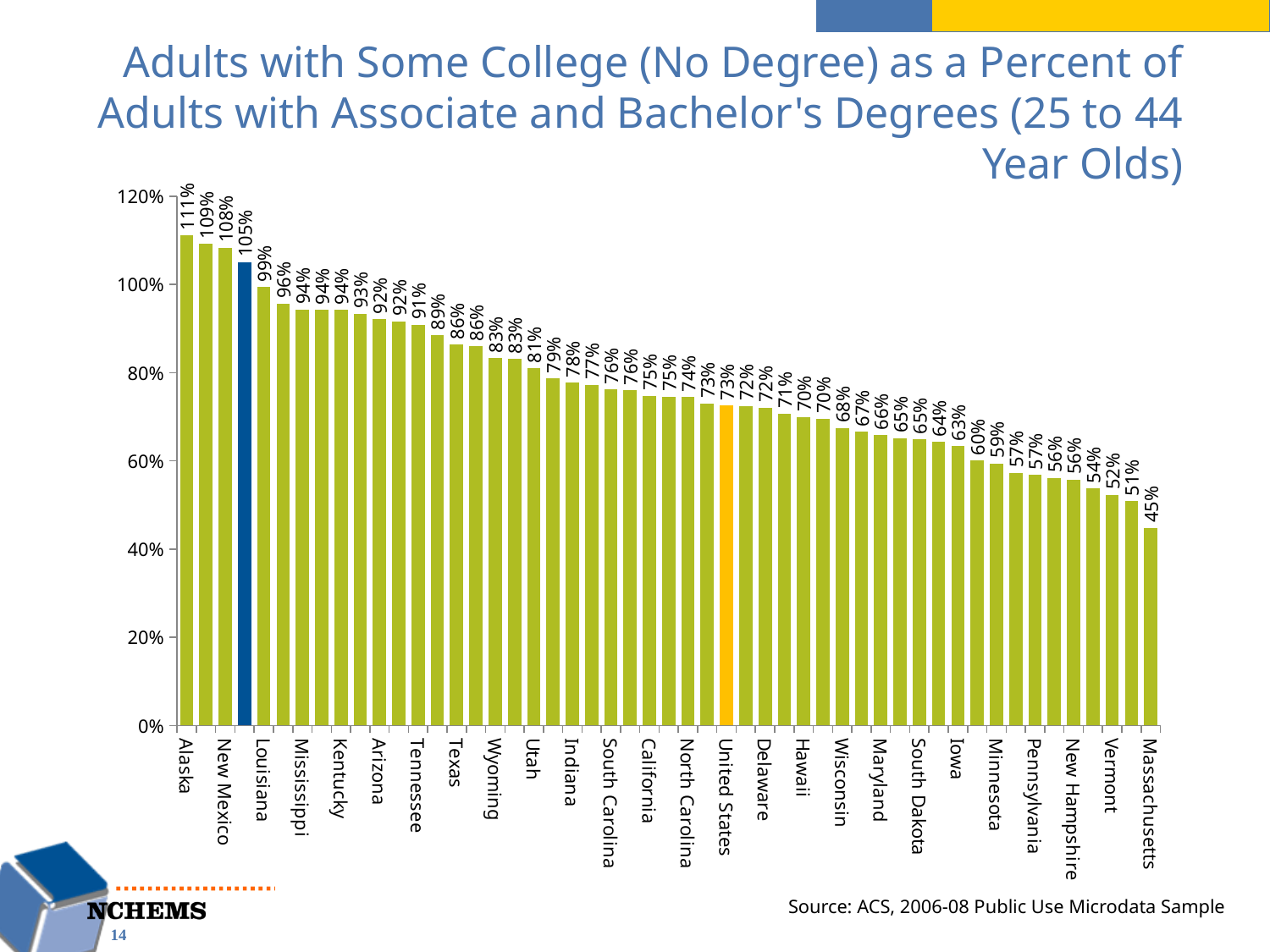
Do the values rise or fall moving from left to right along the x axis? Fall What is the value for the United States? 73% How many bars are plotted in the chart? 51 What data source is cited below the chart? ACS, 2006-08 Public Use Microdata Sample Which is larger, the value for Alaska or the value for the United States? Alaska What is the value for Massachusetts? 45% Is the value for Massachusetts greater or less than 60%? less What is the difference between the values for Alaska and Massachusetts? 66 percentage points What kind of chart is shown on the slide? Bar chart Which category has the highest value? Alaska What is the value for Alaska? 111% Which category has the lowest value? Massachusetts